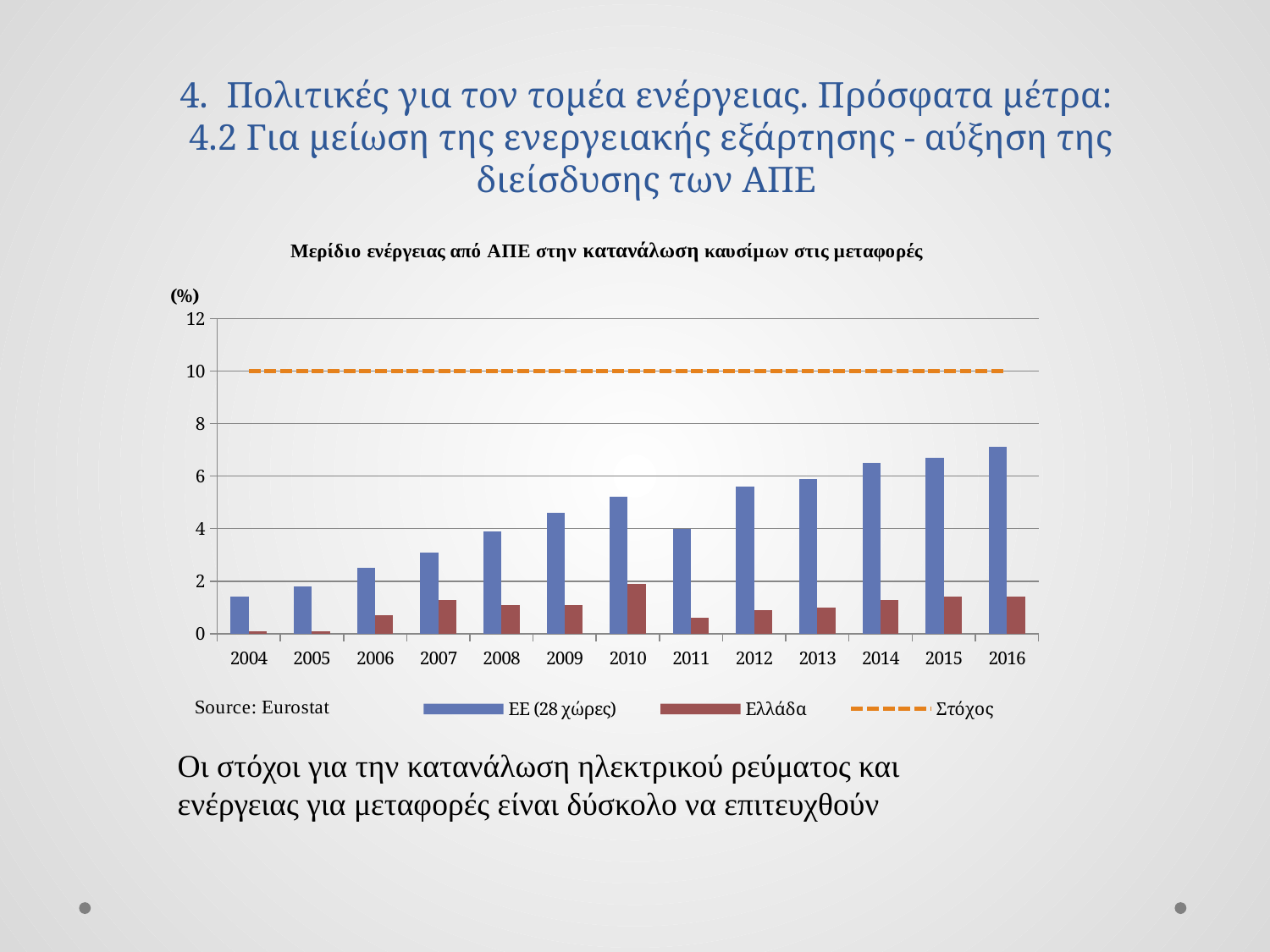
What kind of chart is shown on the slide? combination bar and line chart In which year is the value for ΕΕ (28 χώρες) lowest? 2004 In which year is the value for ΕΕ (28 χώρες) highest? 2016 At what level does the dashed Στόχος line sit on the chart? 10 Is the value for ΕΕ (28 χώρες) in 2010 greater or less than 4? greater In which year is the value for Ελλάδα highest? 2010 Do the values for ΕΕ (28 χώρες) generally rise or fall from 2004 to 2016? rise Which is larger in 2016, the value for ΕΕ (28 χώρες) or the value for Ελλάδα? ΕΕ (28 χώρες) How many entries does the chart's legend list? 3 Is the value for ΕΕ (28 χώρες) in 2004 greater or less than 2? less Is the value for ΕΕ (28 χώρες) in 2016 greater or less than 6? greater How many years are shown on the x axis of the chart? 13